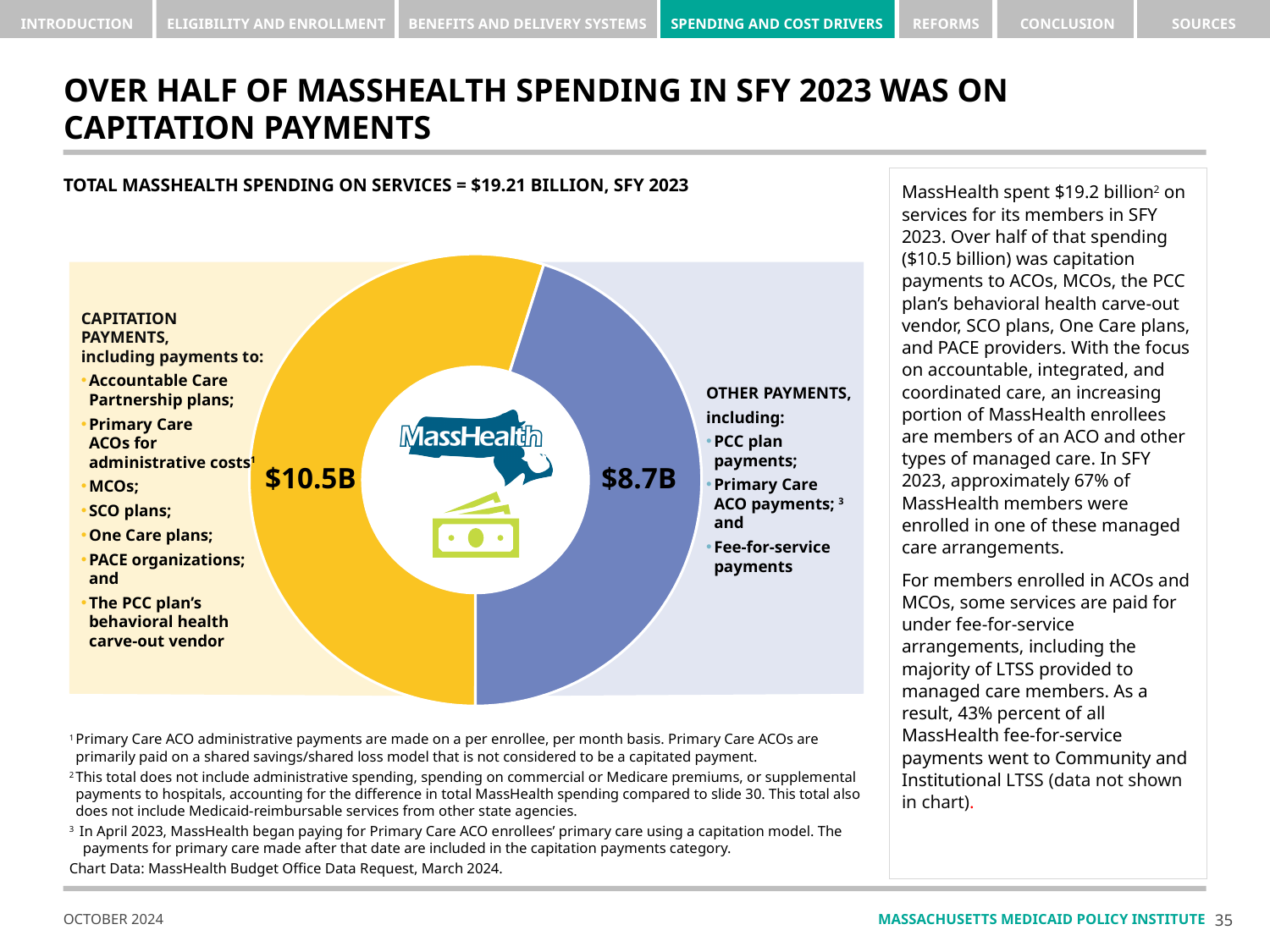
Which is larger, Capitation Payments or Other Payments? Capitation Payments What is the value of the Capitation Payments slice? $10.5B What is the difference between the Capitation Payments value and the Other Payments value? $1.8B What colour is the Capitation Payments slice? Yellow Does the Capitation Payments slice represent more or less than half of the chart? More than half Which slice of the chart is the largest? Capitation Payments What is the value of the Other Payments slice? $8.7B What type of chart is shown on the slide? Pie (donut) chart Which slice of the chart is the smallest? Other Payments How many slices does the chart have? 2 What fiscal year does the chart cover? SFY 2023 According to the chart subtitle, what was total MassHealth spending on services in SFY 2023? $19.21 billion